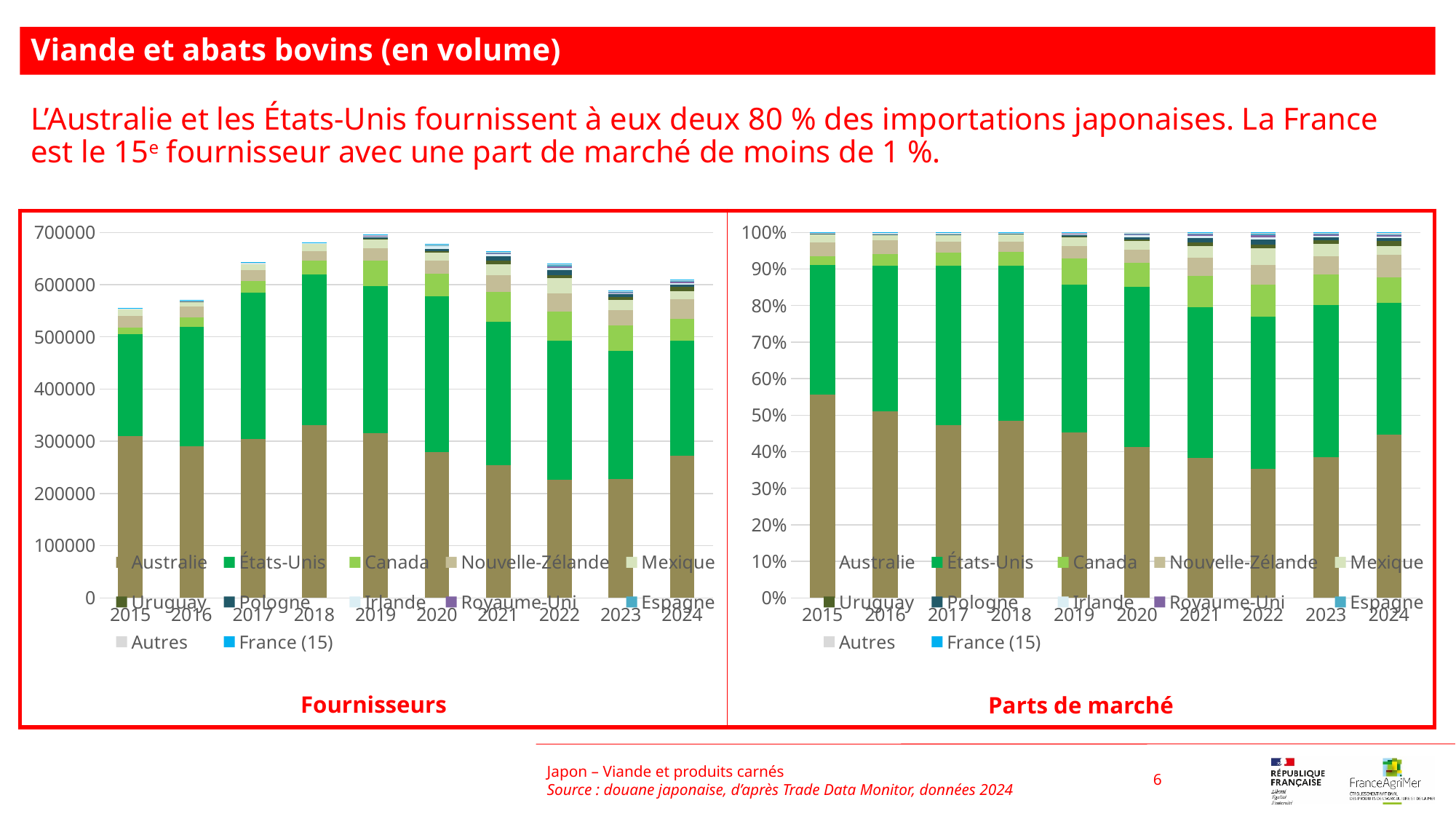
What kind of chart is the 'Fournisseurs' chart on the left? stacked bar chart In the 'Fournisseurs' chart, which year has the tallest total bar? 2019 Which legend entry in the 'Fournisseurs' chart is shown in light blue and listed last? France (15) In the 'Parts de marché' chart, is the Australie share for 2024 greater or less than 50%? less In the 'Parts de marché' chart, is the Australie share for 2015 greater or less than 50%? greater In the 'Fournisseurs' chart, is the total height of the 2018 bar greater or less than 600000? greater How many series does the legend of the 'Fournisseurs' chart list? 12 In the 'Parts de marché' chart, does the Australie share overall rise or fall from 2015 to 2024? fall In the 'Fournisseurs' chart, is the Australie segment larger in 2015 or in 2024? 2015 How many years are shown on the x axis of the 'Parts de marché' chart? 10